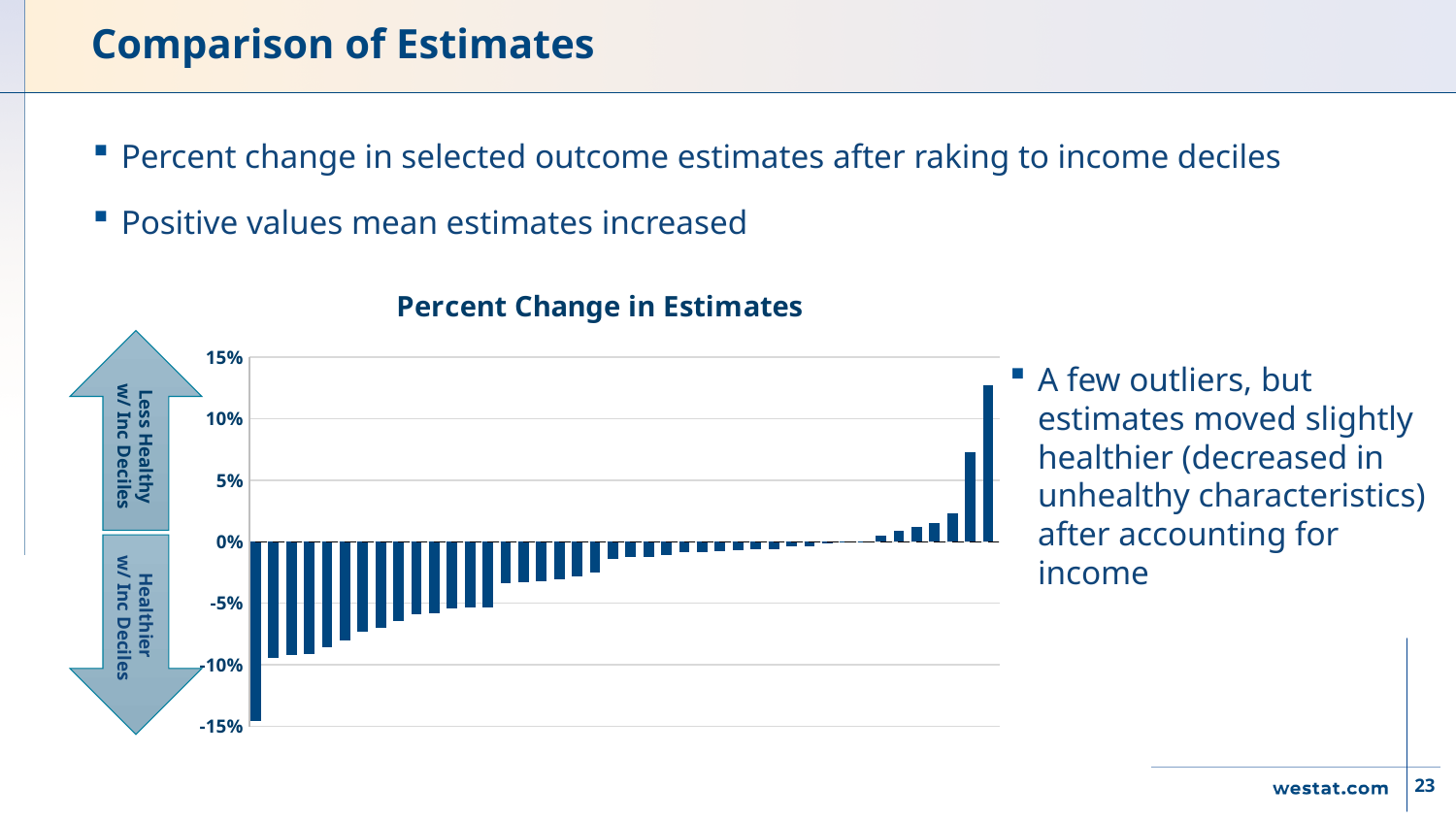
Is the value of the second bar from the left greater or less than -5%? less Do the bar values rise or fall moving from left to right along the x axis? Rise Which is larger, the value of the leftmost bar or the value of the rightmost bar? The rightmost bar Is the value of the rightmost bar greater or less than 10%? greater Is the value of the second bar from the right greater or less than 5%? greater What kind of chart is shown on the slide? Bar chart What is the title of the chart? Percent Change in Estimates Which bar has the highest value in the chart? The rightmost bar Which bar has the lowest value in the chart? The leftmost bar Are most of the bars in the chart above or below 0%? Below 0%